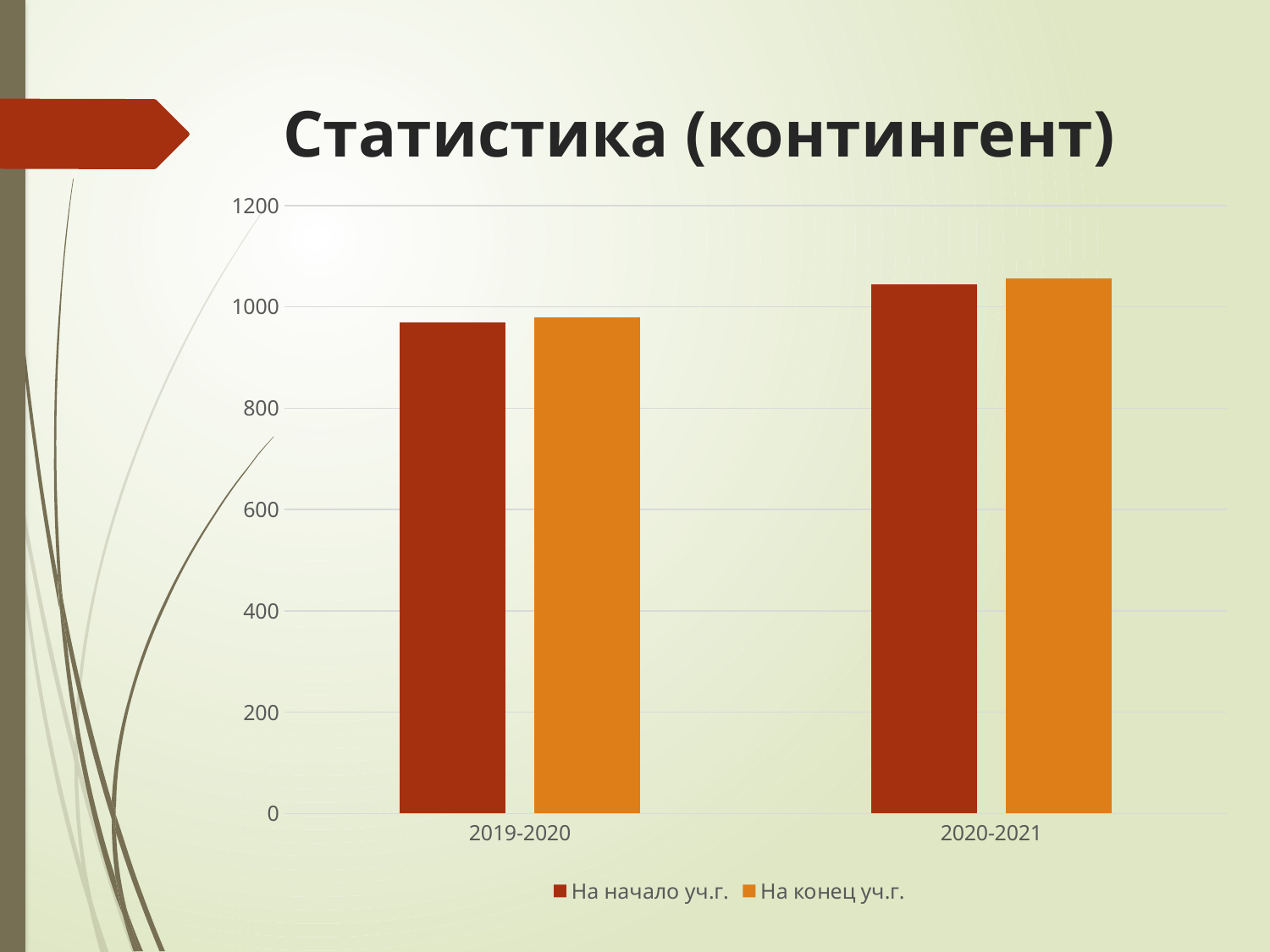
What is the title of the slide containing the chart? Статистика (контингент) Which year has the larger value for На конец уч.г., 2019-2020 or 2020-2021? 2020-2021 How many series does the legend of the chart list? 2 Is the value for На конец уч.г. in 2020-2021 greater or less than 1200? less What kind of chart is shown on the slide? bar chart Do the values for На начало уч.г. rise or fall from 2019-2020 to 2020-2021? rise What are the two series named in the chart legend? На начало уч.г. and На конец уч.г. Which year has the larger value for На начало уч.г., 2019-2020 or 2020-2021? 2020-2021 Is the value for На начало уч.г. in 2020-2021 greater or less than 1000? greater Is the value for На начало уч.г. in 2019-2020 greater or less than 1000? less How many categories are shown on the x axis of the chart? 2